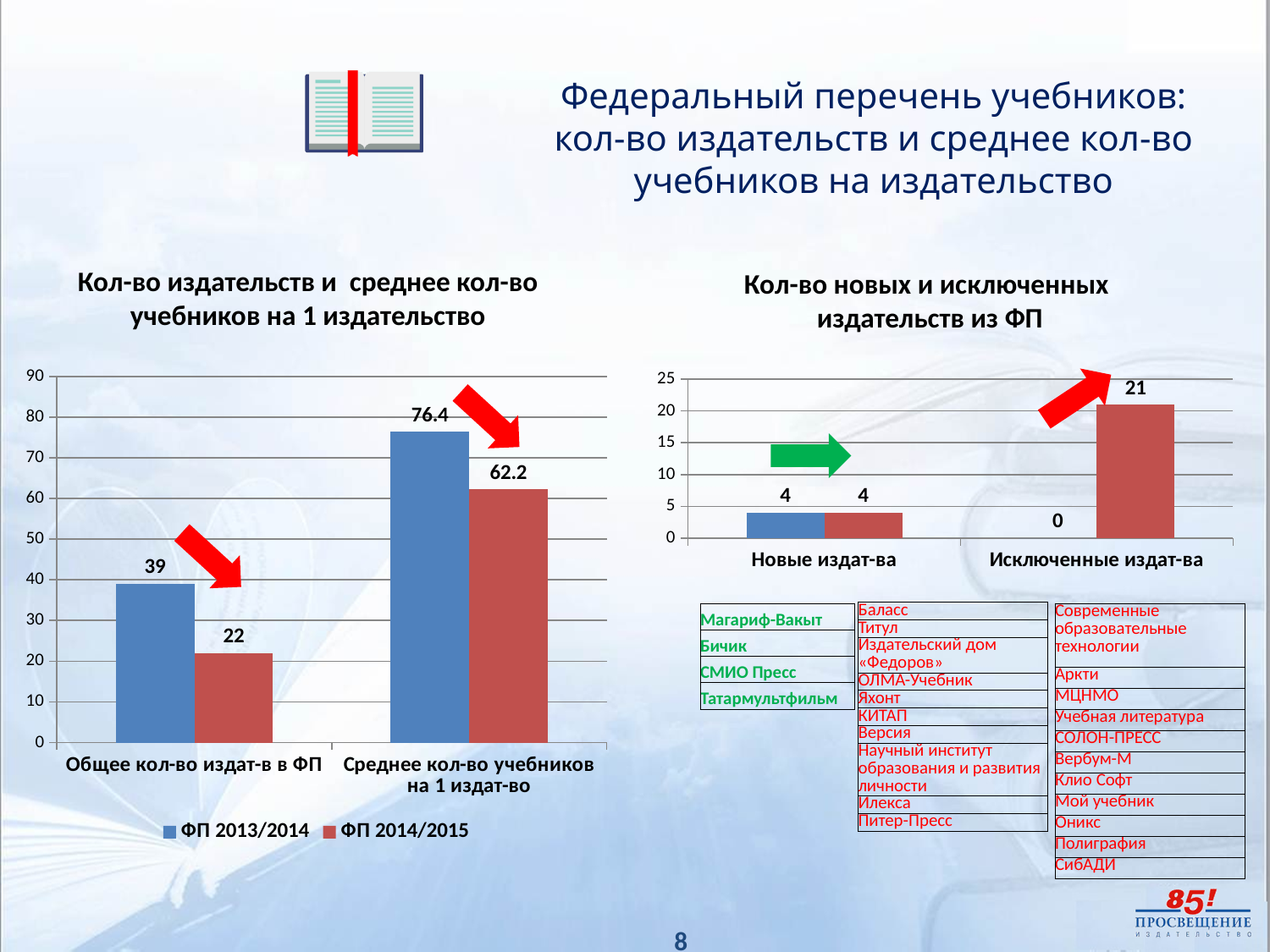
On the left chart, what is the value for ФП 2014/2015 in the category 'Среднее кол-во учебников на 1 издат-во'? 62.2 On the left chart, how many series does the legend list? 2 On the left chart, what is the value for ФП 2013/2014 in the category 'Общее кол-во издат-в в ФП'? 39 On the right chart 'Кол-во новых и исключенных издательств из ФП', what is the difference between the red and blue bars for 'Исключенные издат-ва'? 21 On the left chart, what is the difference between the ФП 2013/2014 and ФП 2014/2015 values for 'Общее кол-во издат-в в ФП'? 17 On the left chart, what colour represents ФП 2014/2015 in the legend? Red On the left chart, what is the highest value shown? 76.4 On the left chart, which series has the larger value for 'Среднее кол-во учебников на 1 издат-во'? ФП 2013/2014 On the right chart 'Кол-во новых и исключенных издательств из ФП', what is the value of the red bar for 'Исключенные издат-ва'? 21 On the right chart 'Кол-во новых и исключенных издательств из ФП', how many categories are shown on the x axis? 2 What type of chart is the left chart? Bar chart On the right chart 'Кол-во новых и исключенных издательств из ФП', what is the value of the blue bar for 'Исключенные издат-ва'? 0